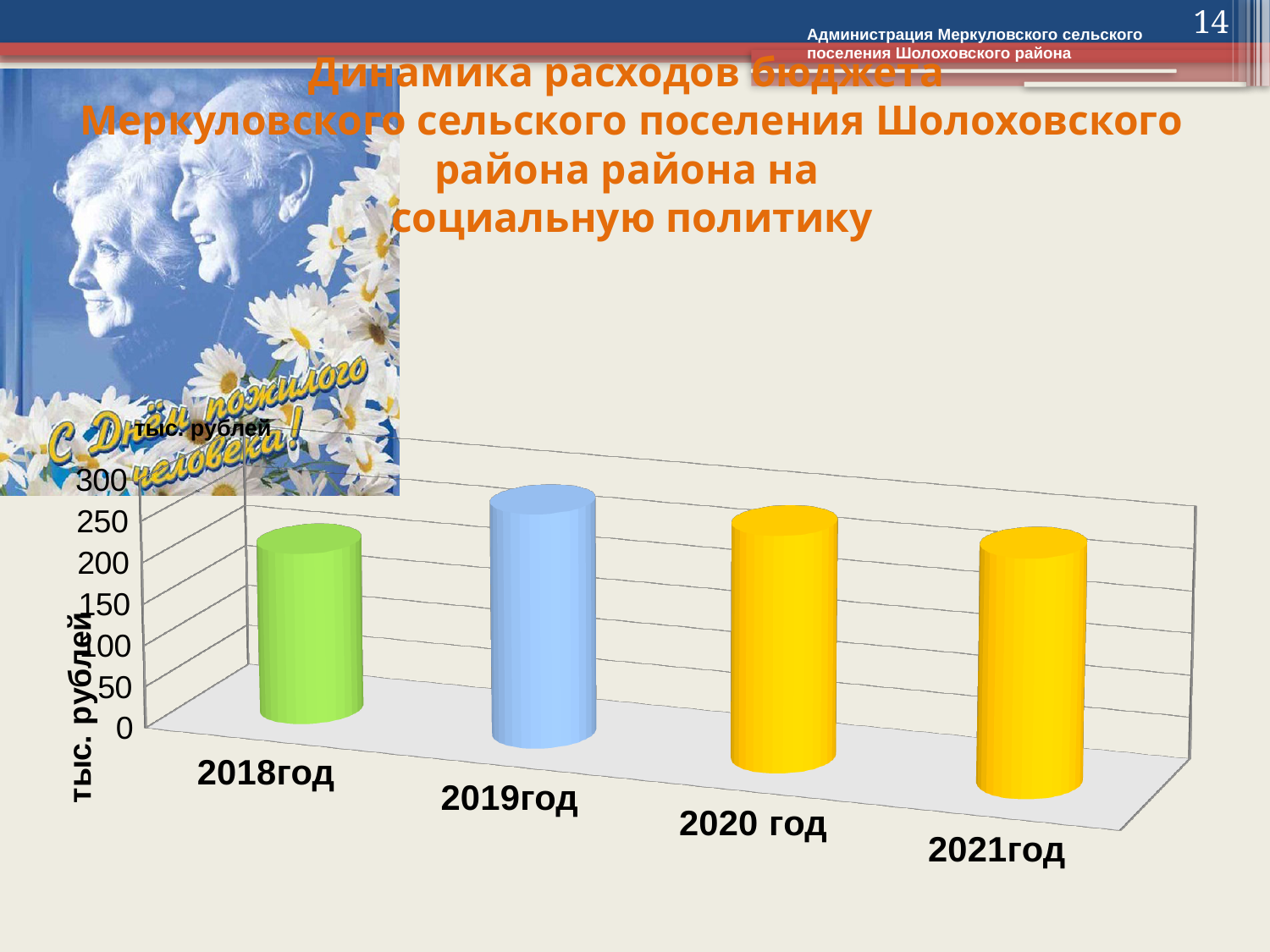
How many years (categories) are shown on the x axis of the chart? 4 Is the value for 2019год greater or less than 150? greater Is the value for 2020 год greater or less than 150? greater Is the value for 2018год greater or less than 100? greater What is the highest tick value shown on the vertical axis of the chart? 300 Which year is the first category on the x axis of the chart? 2018год Which is larger, the value for 2018год or the value for 2019год? 2019год Which year has the lowest bar in the chart? 2018год What kind of chart is shown on the slide? bar chart What is the unit label on the vertical axis of the chart? тыс. рублей